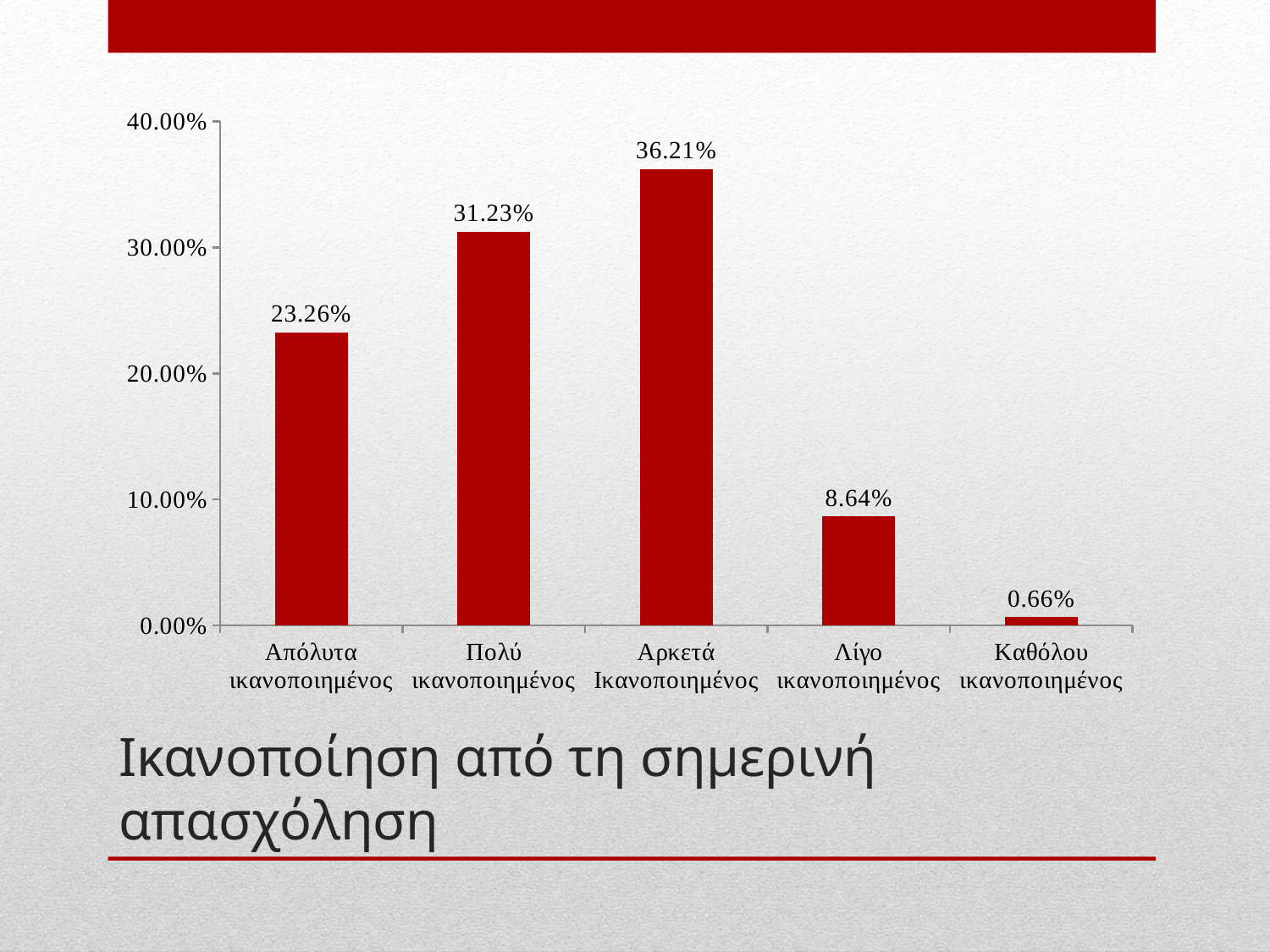
Is the value for Λίγο ικανοποιημένος greater or less than 10.00%? less What is the value for Καθόλου ικανοποιημένος? 0.66% What is the value for Λίγο ικανοποιημένος? 8.64% Which category has the highest value? Αρκετά Ικανοποιημένος Which category has the lowest value? Καθόλου ικανοποιημένος What is the difference between the values for Απόλυτα ικανοποιημένος and Λίγο ικανοποιημένος? 14.62% What is the value for Αρκετά Ικανοποιημένος? 36.21% How many categories are shown on the x axis? 5 What is the title of the slide? Ικανοποίηση από τη σημερινή απασχόληση Which is larger, the value for Απόλυτα ικανοποιημένος or the value for Πολύ ικανοποιημένος? Πολύ ικανοποιημένος What kind of chart is shown on the slide? bar chart What is the difference between the values for Αρκετά Ικανοποιημένος and Πολύ ικανοποιημένος? 4.98%